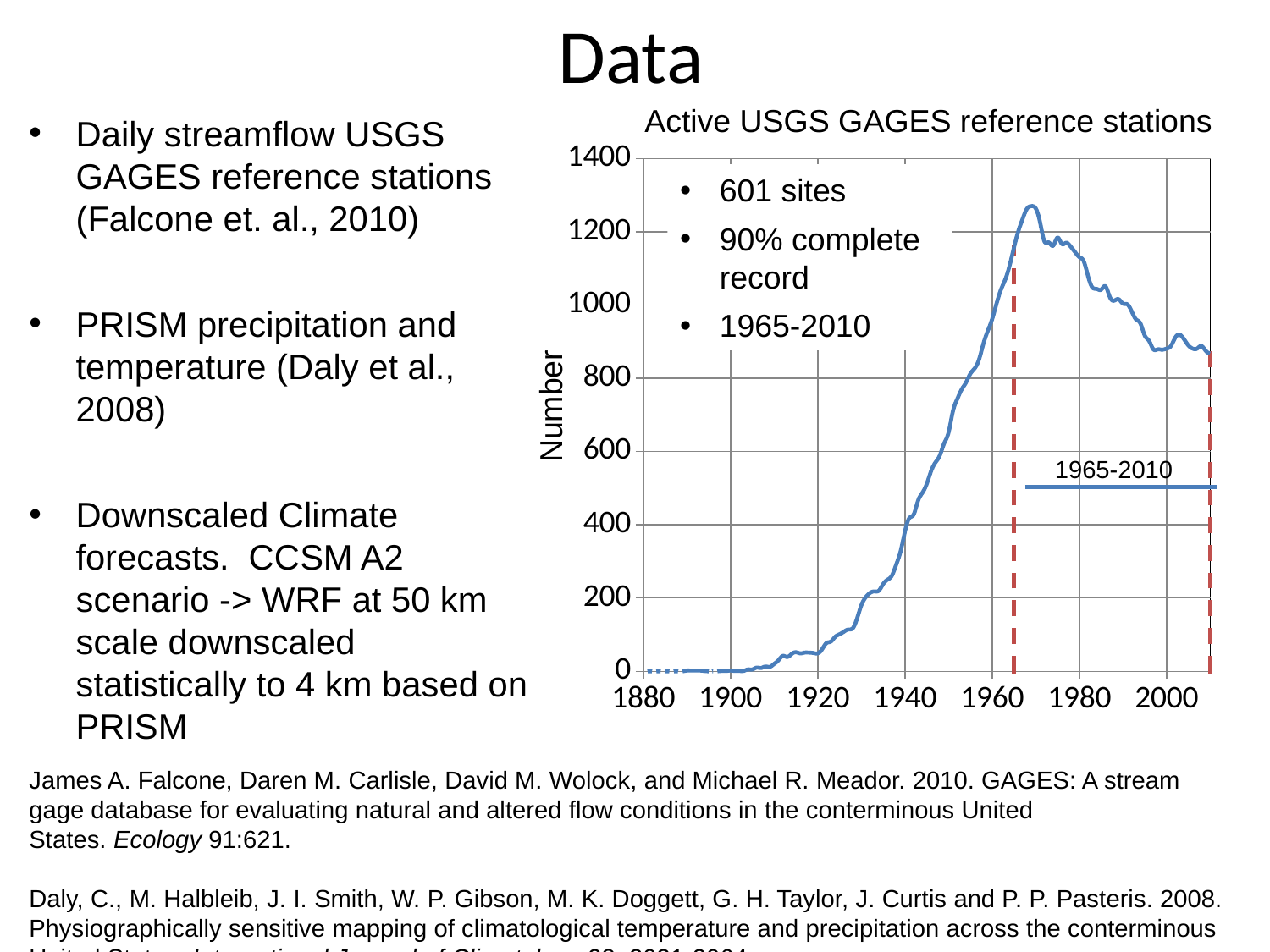
What is the title of the chart? Active USGS GAGES reference stations Is the value for 1980 greater or less than 1000? greater What is the label on the y axis of the chart? Number Is the peak value of the line greater or less than 1200? greater Is the value for 1940 greater or less than 600? less What kind of chart is shown on the slide? line chart Does the number of active stations rise or fall between 1920 and 1965? rise Does the number of active stations rise or fall between 1970 and 2010? fall Which of the two years, 1940 or 1980, has the larger number of active stations? 1980